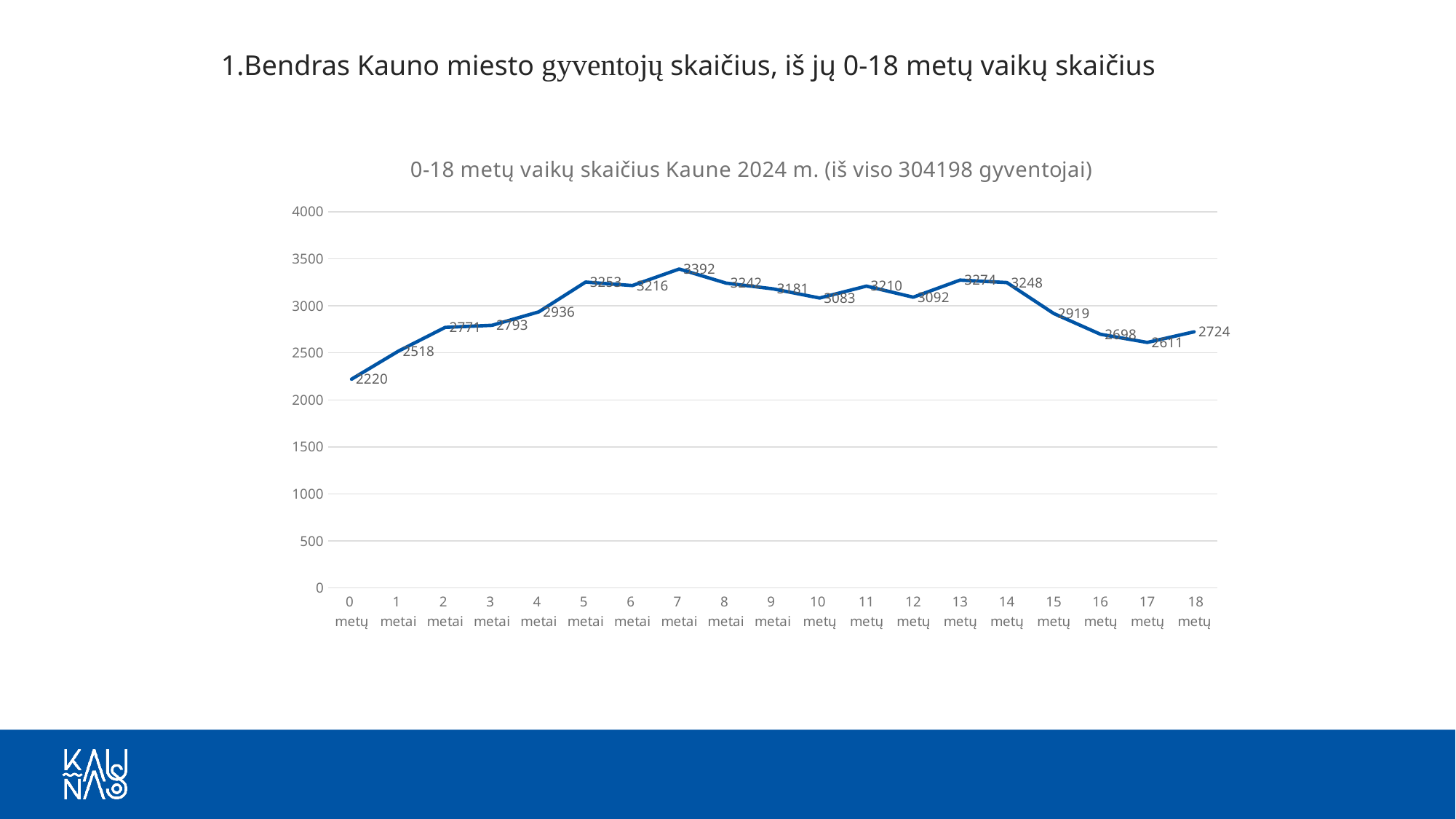
What is the value for 7 metai? 3392 What is the value for 18 metų? 2724 Which age category has the highest value? 7 metai What is the value for 15 metų? 2919 How many age categories are plotted on the x axis? 19 What type of chart is shown on the slide? line chart Is the value for 17 metų greater or less than 3000? less What is the number of children aged 0 metų? 2220 Which age category has the lowest value? 0 metų What is the title of the chart? 0-18 metų vaikų skaičius Kaune 2024 m. (iš viso 304198 gyventojai) Which is larger, the value for 11 metų or the value for 12 metų? 11 metų What is the difference between the values for 7 metai and 0 metų? 1172